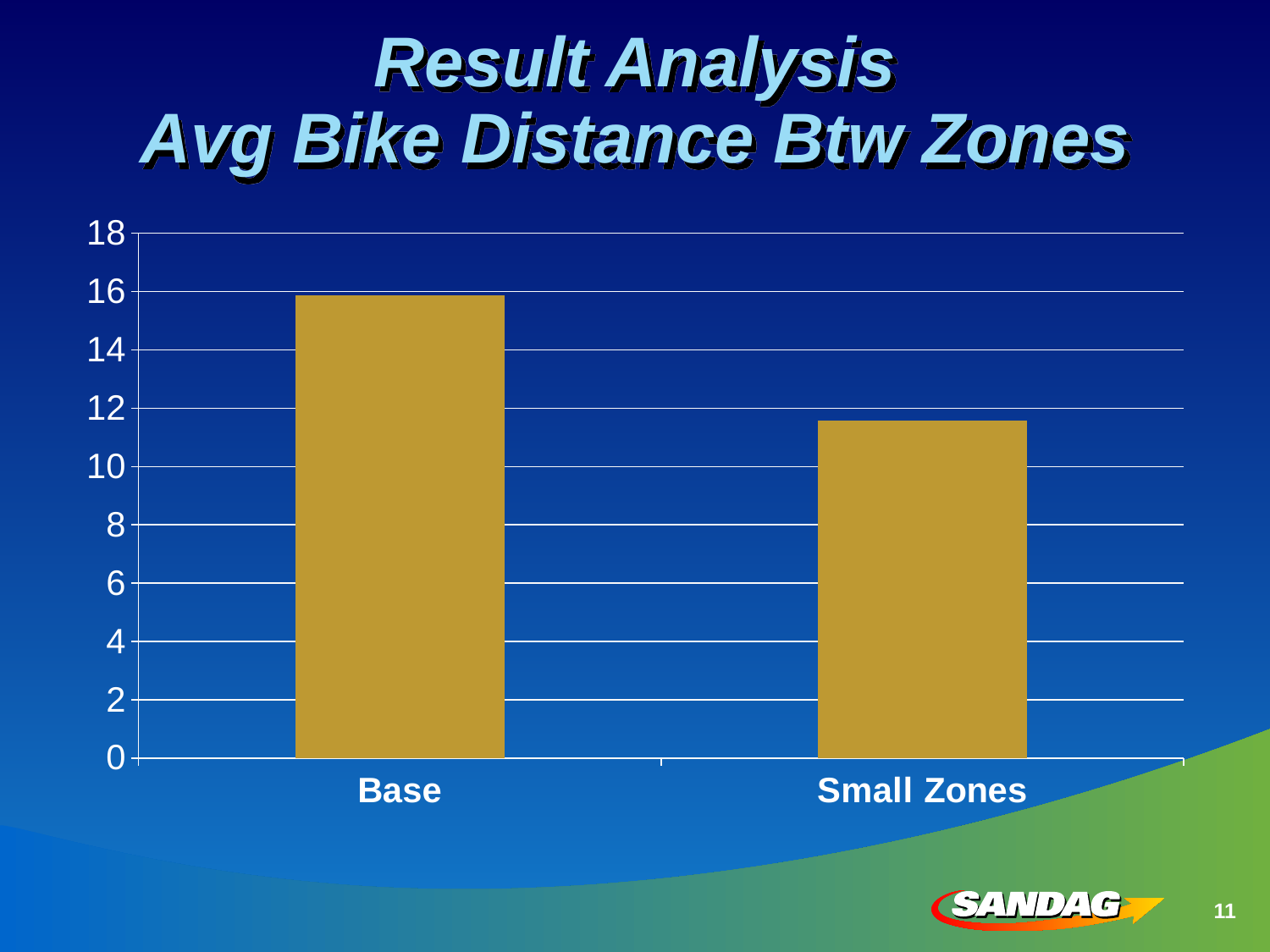
Which category has the lowest value? Small Zones Is the value for Base greater or less than 18? less What kind of chart is shown on the slide? bar chart Do the values rise or fall moving from Base to Small Zones along the x axis? fall Is the value for Small Zones greater or less than 14? less What is the highest value shown on the vertical axis? 18 What is the title shown above the chart on the slide? Result Analysis Avg Bike Distance Btw Zones Is the value for Small Zones greater or less than 10? greater Which is larger, the value for Base or the value for Small Zones? Base How many categories are plotted on the chart? 2 Which category has the highest value? Base